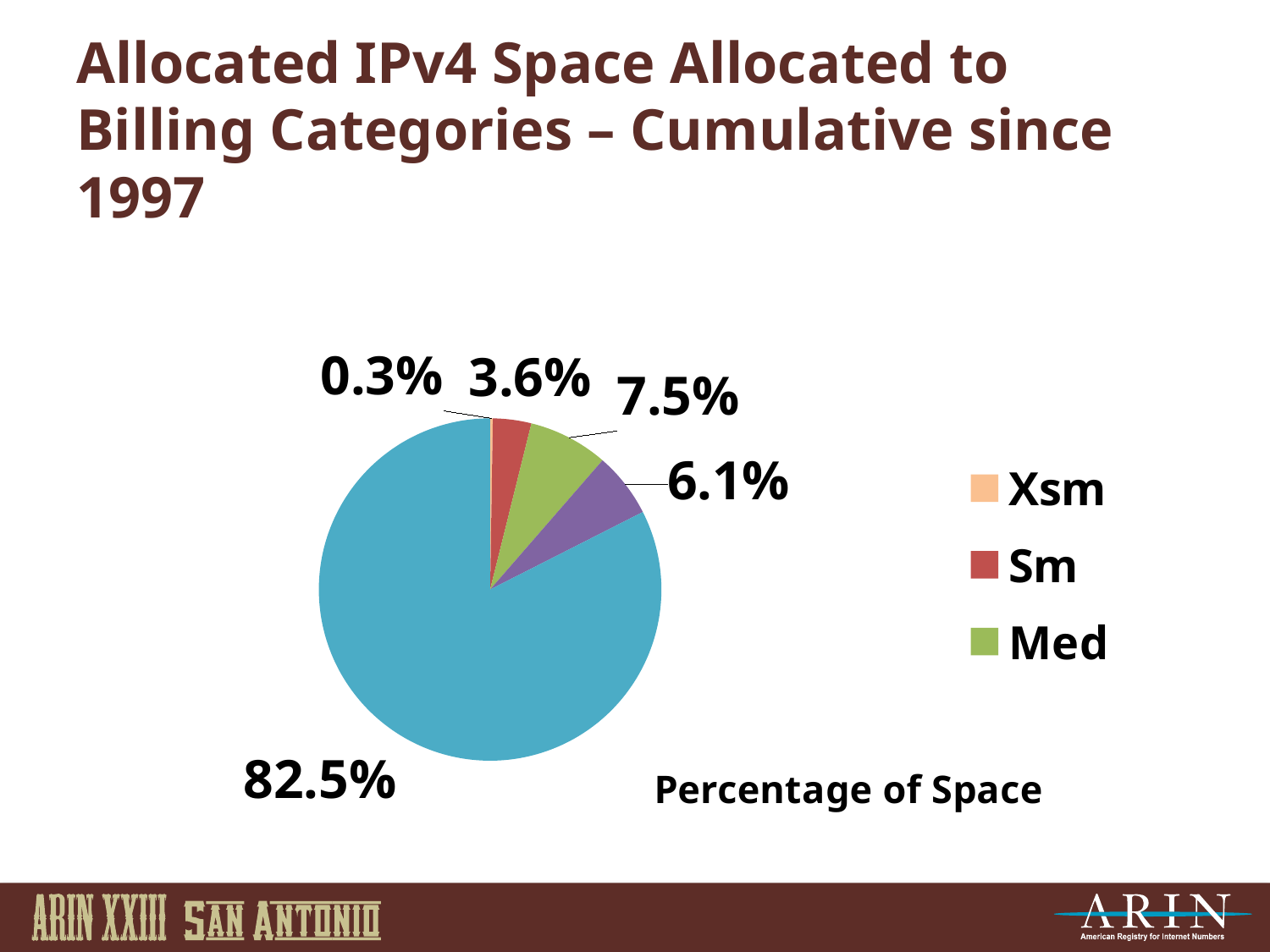
What is the largest percentage value labelled on the pie chart? 82.5% Which legend category has the smallest share of the pie? Xsm How many slices does the pie chart have? 5 What label appears below the pie chart to the right? Percentage of Space Which has a larger share of the pie, Sm or Med? Med What percentage of space is shown for the Med category? 7.5% What is the difference between the Med and Sm percentages? 3.9% What is the combined percentage of the Xsm, Sm and Med slices? 11.4% What percentage of space is shown for the Xsm category? 0.3% How many categories are listed in the legend? 3 What percentage of space is shown for the Sm category? 3.6% What kind of chart is shown on the slide? pie chart